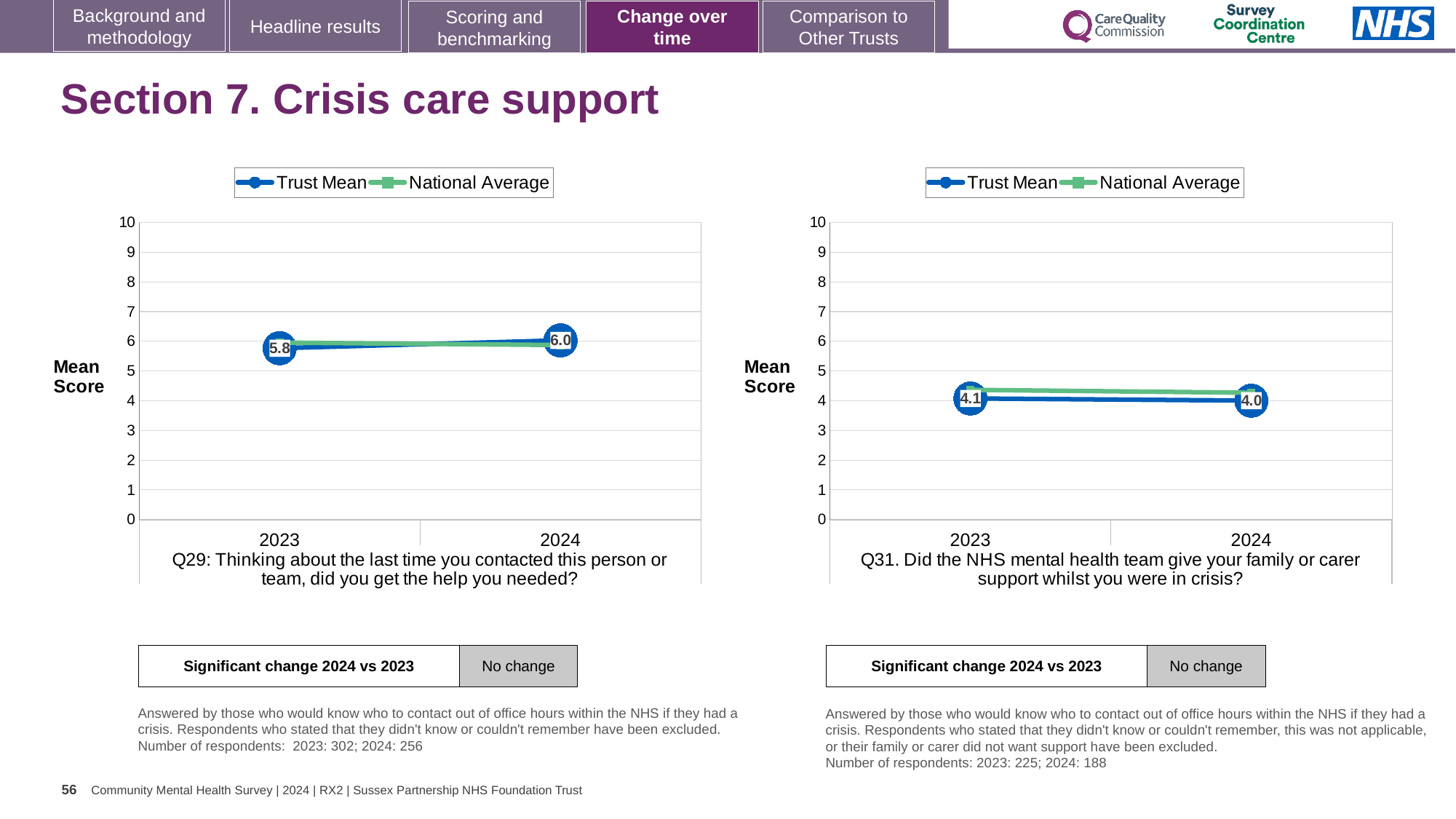
In the left chart (Q29), what is the Trust Mean score for 2023? 5.8 How many years are plotted on the x axis of the left chart (Q29)? 2 How many series does the legend of the right chart (Q31) list? 2 In the left chart (Q29), by how much did the Trust Mean change from 2023 to 2024? 0.2 In the left chart (Q29), what is the Trust Mean score for 2024? 6.0 What type of chart is used for Q29 on the left? line chart In the right chart (Q31), is the National Average value for 2024 greater or less than 5? less In the left chart (Q29), does the Trust Mean rise or fall from 2023 to 2024? rise In the right chart (Q31), what is the Trust Mean score for 2024? 4.0 In the left chart (Q29), is the National Average value for 2023 greater or less than 5? greater In the right chart (Q31), which year has the higher Trust Mean score, 2023 or 2024? 2023 In the right chart (Q31), what is the Trust Mean score for 2023? 4.1